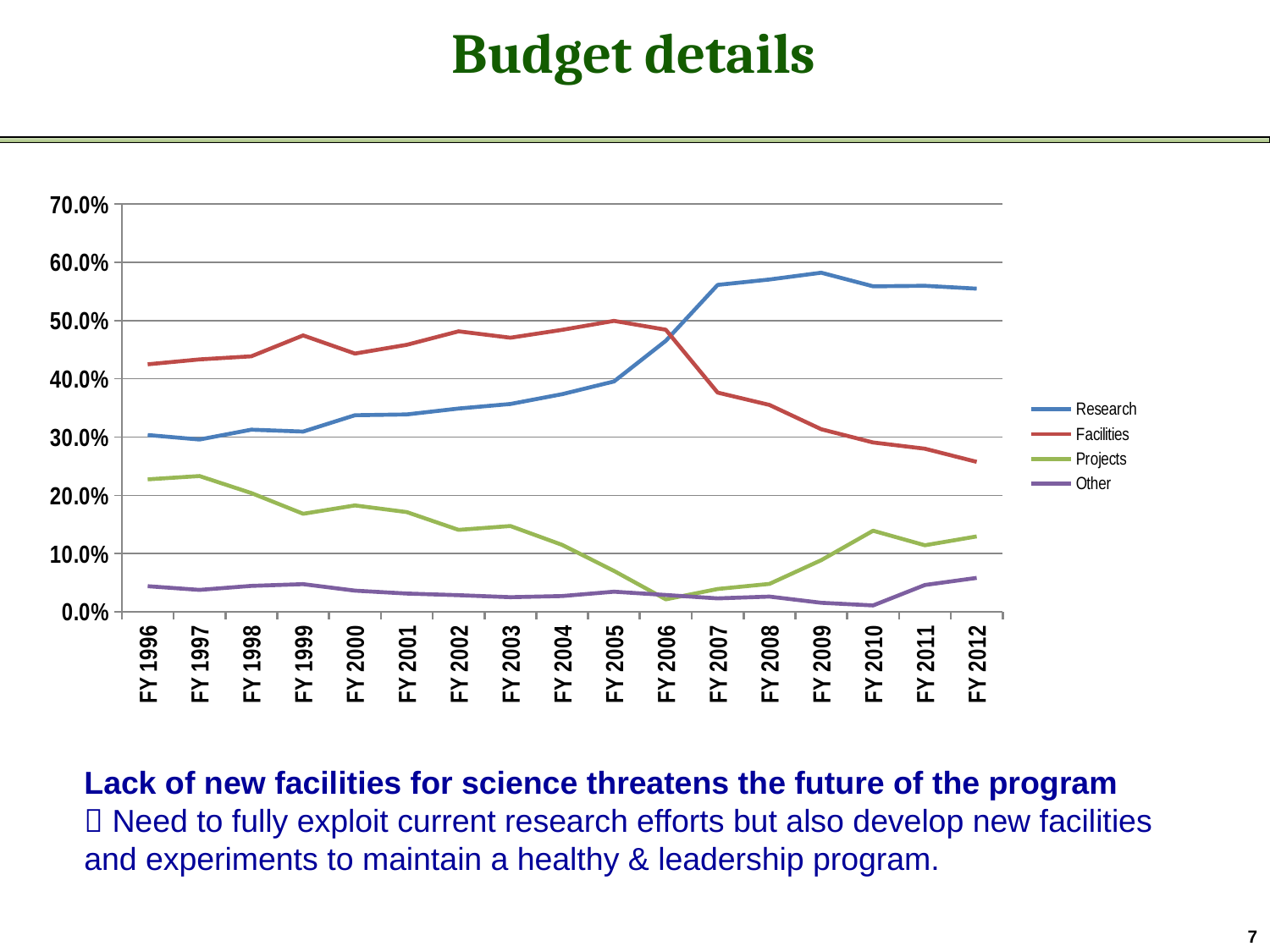
Which series has the highest value in FY 2012? Research Does the Facilities line rise or fall from FY 2007 to FY 2012? Fall In FY 1996, which is larger: Facilities or Research? Facilities Is the value for Research in FY 2012 greater or less than 50%? greater What colour is the Research line in the legend? Blue Is the value for Projects in FY 1996 greater or less than 20%? greater Which series has the highest value in FY 2000? Facilities Which series has the lowest value in FY 2012? Other How many fiscal years are plotted along the x axis? 17 Is the value for Facilities in FY 2012 greater or less than 30%? less How many series does the legend list? 4 What kind of chart is shown on the slide? Line chart